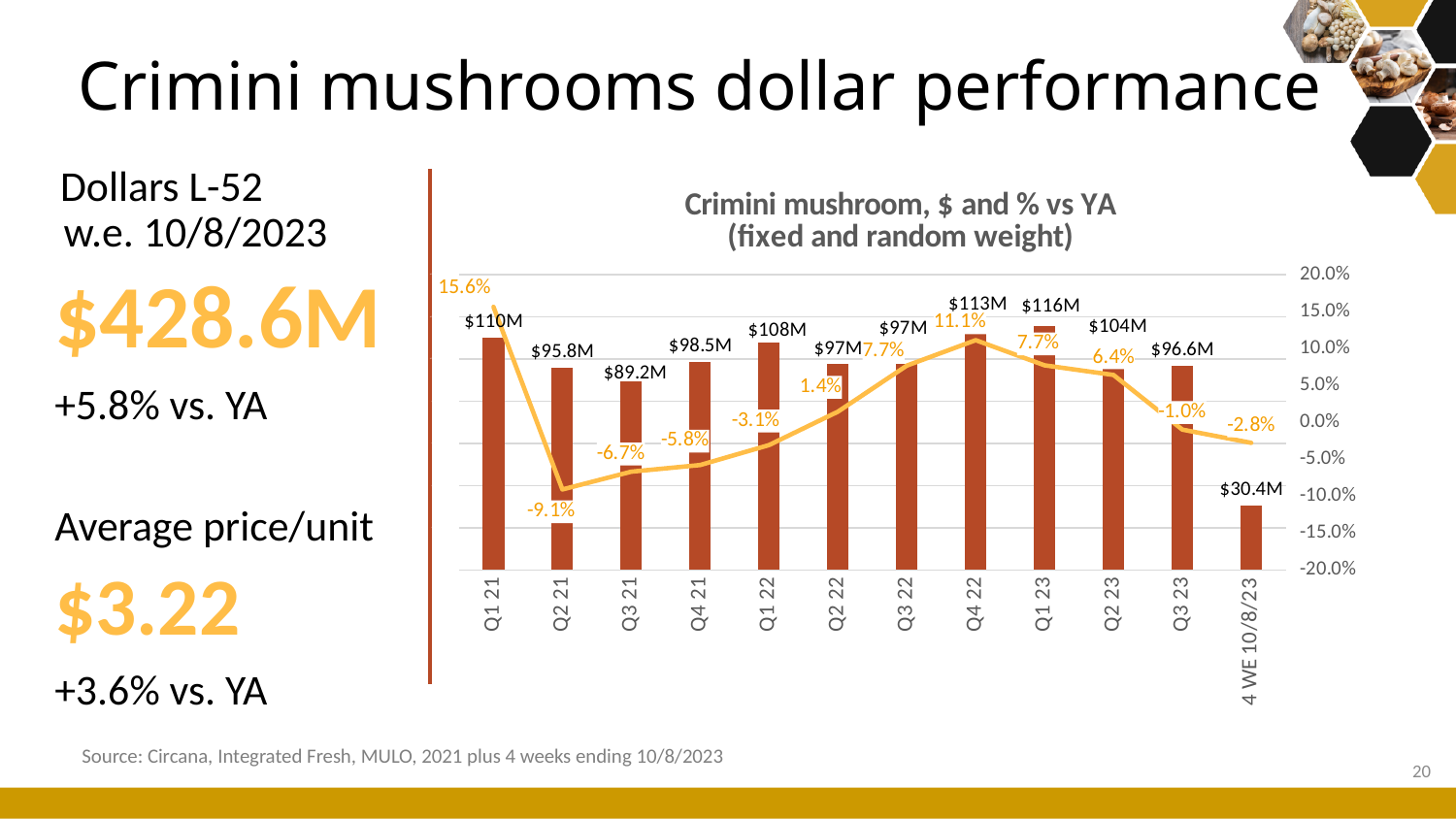
What is the dollar value shown for the 4 WE 10/8/23 period? $30.4M What is the difference in dollar value between Q1 23 and Q2 23? $12M Which period has the lowest % vs YA value on the line? Q2 21 What is the dollar value shown for Q3 21? $89.2M Which quarter has the highest dollar value among the bars? Q1 23 Which period has the highest % vs YA value on the line? Q1 21 What is the % vs YA value shown for Q4 22? 11.1% What kind of chart is shown on the slide? Combination bar and line chart What is the dollar value shown for Q1 23? $116M How many periods are shown on the x axis of the chart? 12 What is the % vs YA value shown for Q2 21? -9.1% Which has the larger dollar value, Q4 21 or Q1 22? Q1 22